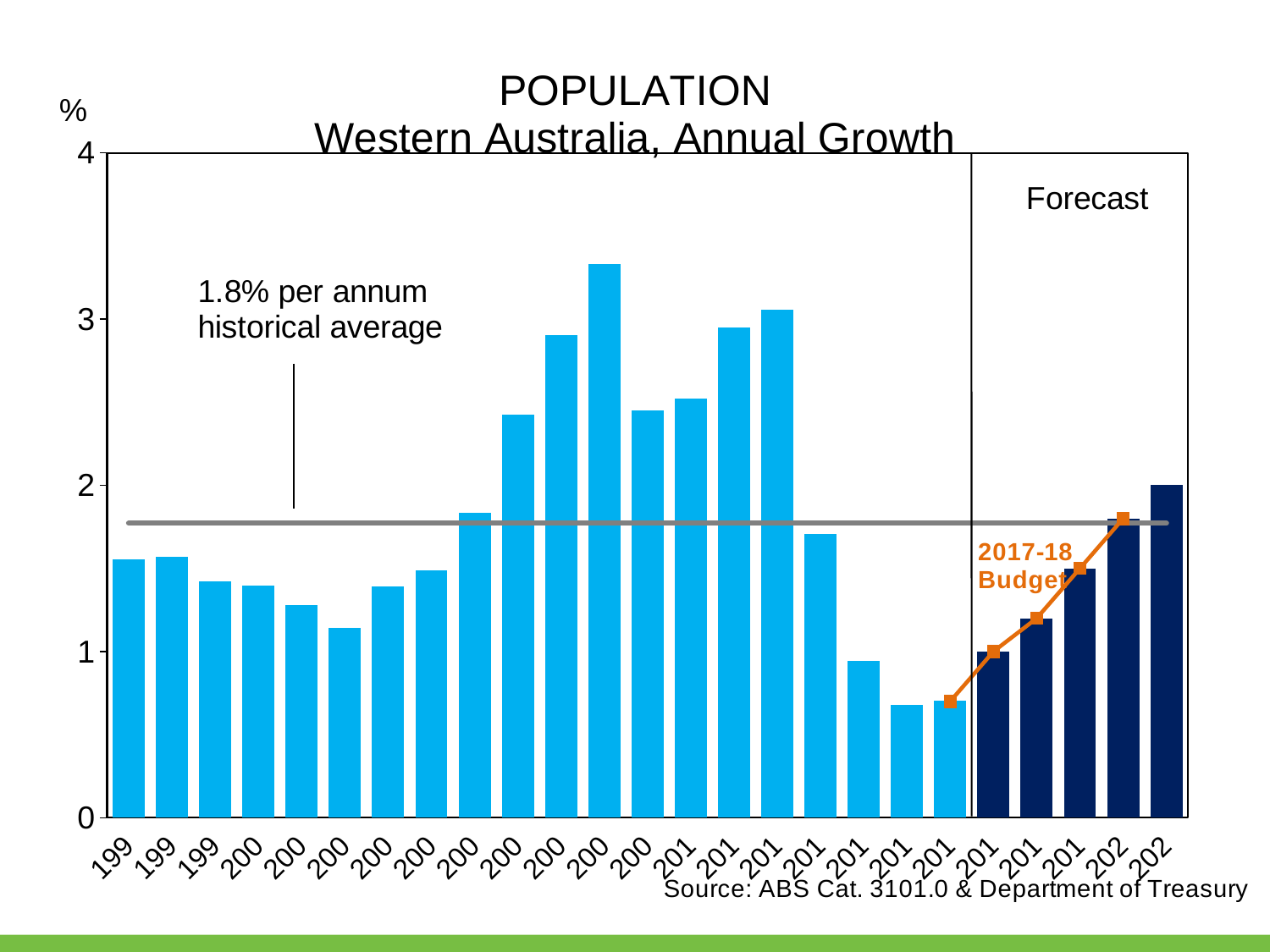
Do the values of the first six bars on the left generally rise or fall from left to right? fall Is the value of the shortest bar greater or less than 1? less What label is given to the orange line in the Forecast section? 2017-18 Budget What is the title of the chart? POPULATION Western Australia, Annual Growth What historical average annual growth rate is annotated on the chart? 1.8% per annum What kind of chart is shown on the slide? Combination bar and line chart Do the bars in the Forecast section rise or fall from left to right? rise What is the highest value shown on the vertical axis? 4 How many dark blue bars are in the Forecast section of the chart? 5 Is the value of the tallest bar greater or less than 3? greater Is the tallest bar in the light blue historical section or the dark blue Forecast section? light blue historical section How many bars are plotted in the chart? 25